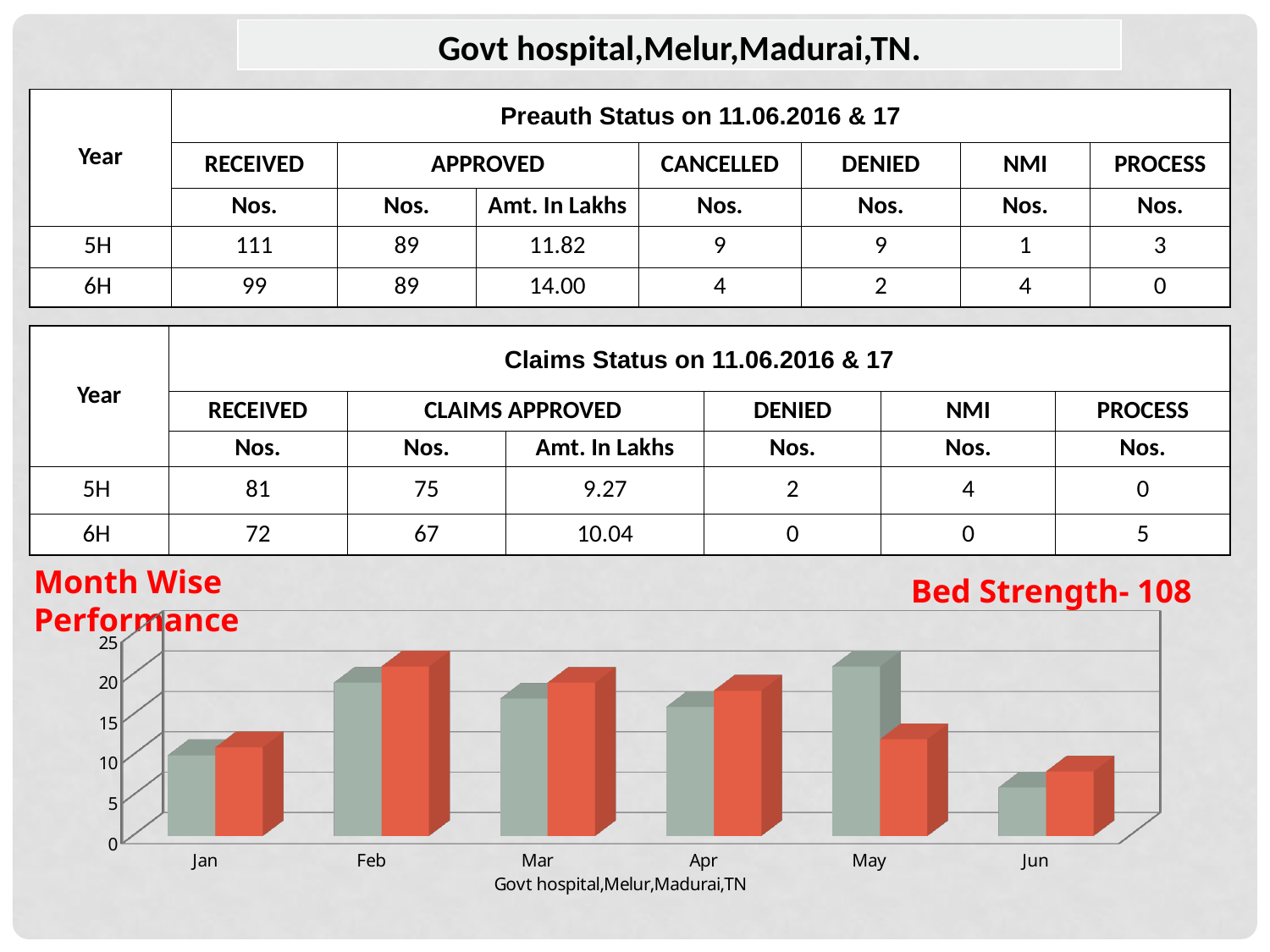
In May, which is larger: the grey bar or the red bar? the grey bar For the grey series, which is larger: Jan or Feb? Feb Which month has the highest value for the red series? Feb Is the grey bar for Jan greater or less than 15? less How many months are shown on the x axis of the chart? 6 Is the grey bar for Jun greater or less than 10? less Is the red bar for Feb greater or less than 15? greater Which month has the lowest value for the grey series? Jun What kind of chart is shown on the slide? bar chart Which month has the lowest value for the red series? Jun What text appears below the x axis of the chart? Govt hospital,Melur,Madurai,TN